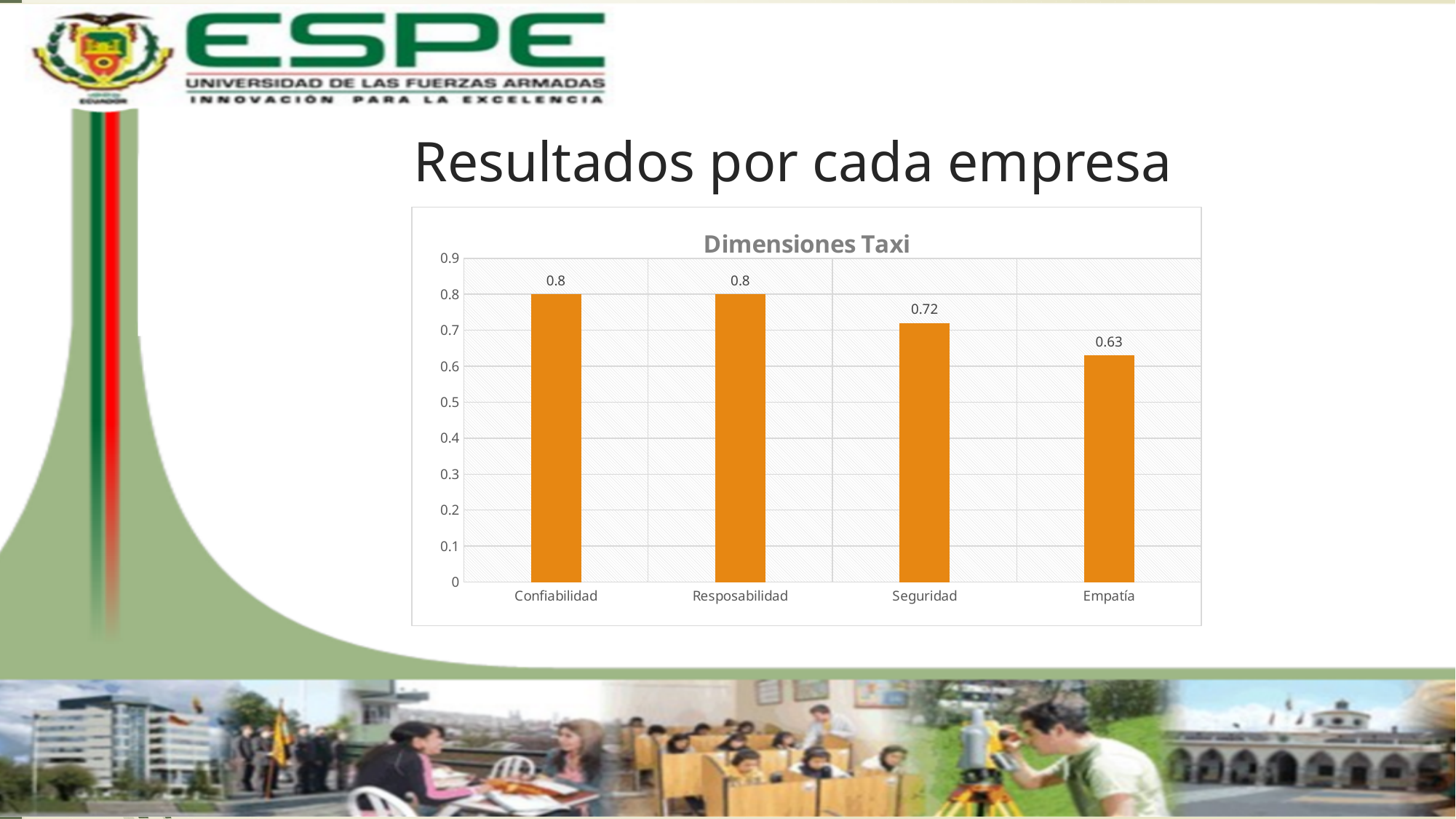
Which is larger, the value for Seguridad or the value for Empatía? Seguridad Which category has the lowest value? Empatía What is the value for Seguridad? 0.72 What is the title of the chart? Dimensiones Taxi What is the value for Confiabilidad? 0.8 What kind of chart is shown? bar chart Is the value for Empatía greater or less than 0.7? less How many categories are shown on the x axis? 4 What is the value for Empatía? 0.63 What is the difference between the values for Seguridad and Empatía? 0.09 What is the difference between the values for Confiabilidad and Seguridad? 0.08 Do the values rise or fall from Confiabilidad to Empatía along the x axis? fall